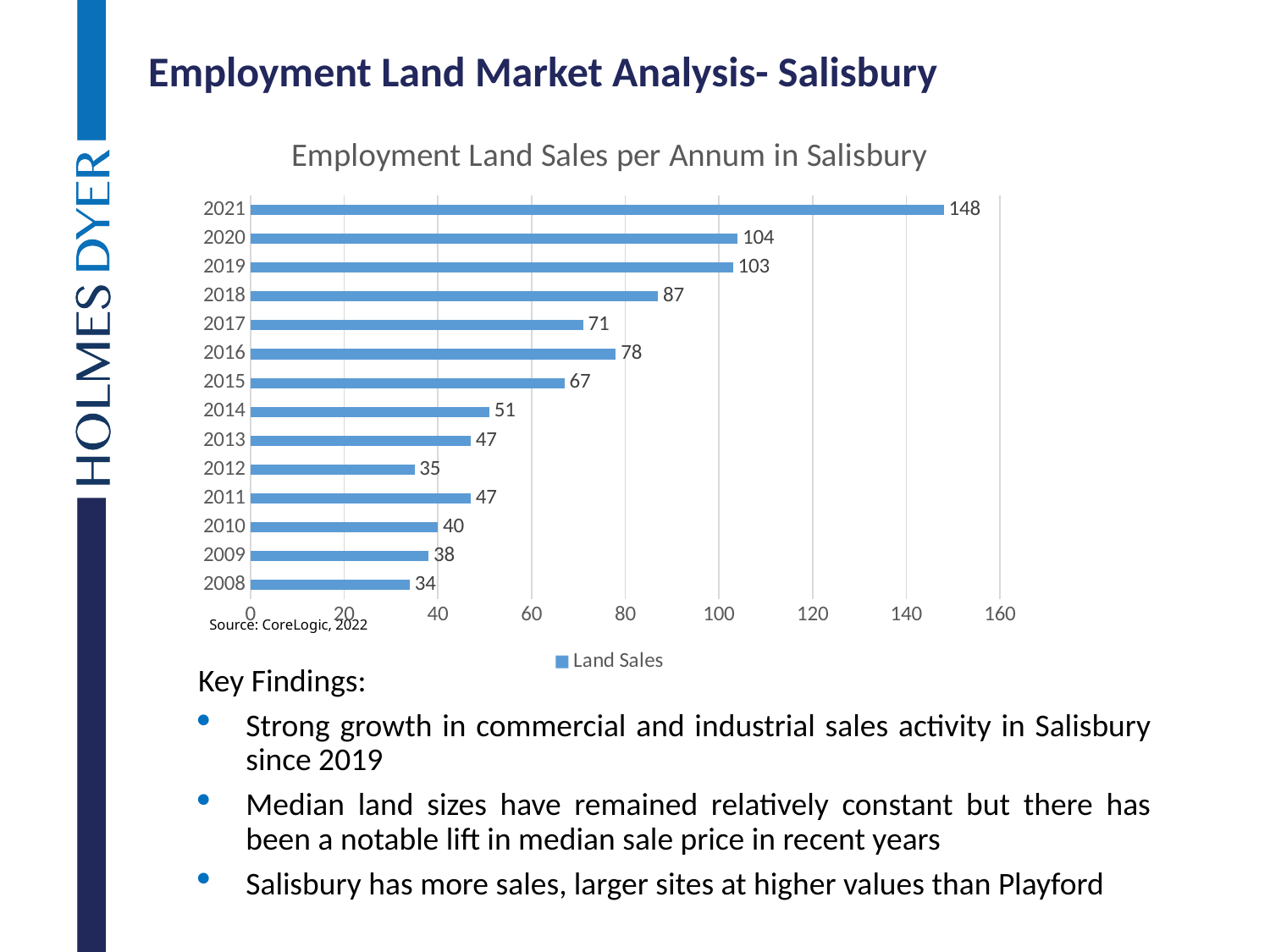
What is the value of Land Sales for 2016? 78 How many series does the legend list? 1 What is the difference in Land Sales between 2021 and 2020? 44 What is the value of Land Sales for 2021? 148 What is the title of the chart? Employment Land Sales per Annum in Salisbury Which year has higher Land Sales, 2016 or 2017? 2016 Which year has the highest Land Sales? 2021 Which year has the lowest Land Sales? 2008 What is the difference in Land Sales between 2018 and 2008? 53 What is the value of Land Sales for 2012? 35 How many years are shown in the chart? 14 What kind of chart is shown on the slide? Bar chart